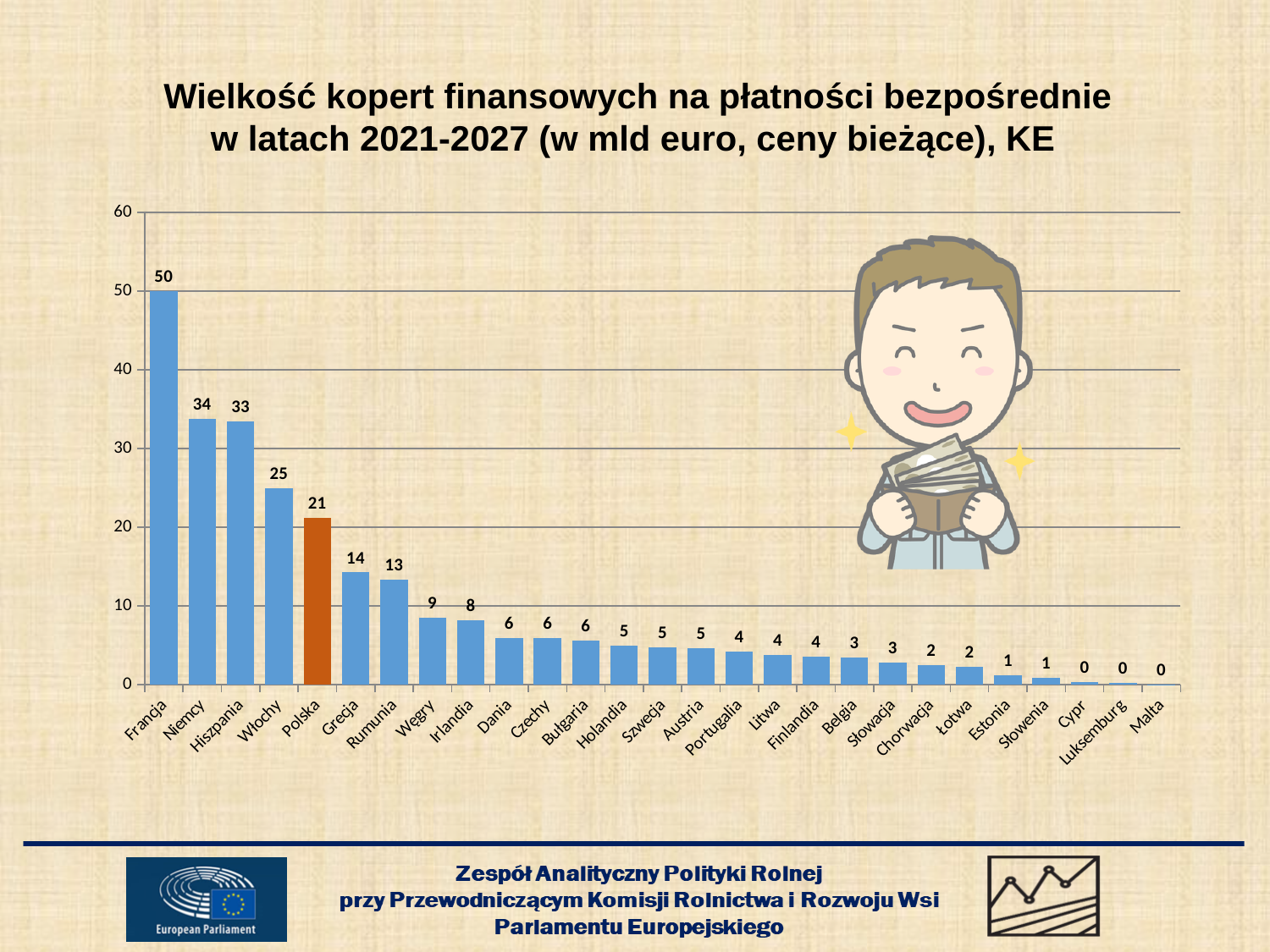
Is the value for Francja greater or less than 40? greater Which is larger, the value for Włochy or the value for Hiszpania? Hiszpania Which country has the highest value? Francja Which country's bar is coloured orange instead of blue? Polska What is the difference between the values for Polska and Grecja? 7 What is the value for Niemcy? 34 Do the values rise or fall from left to right along the x axis? fall What is the value for Polska? 21 What is the difference between the values for Francja and Niemcy? 16 What kind of chart is shown on the slide? bar chart What is the value for Rumunia? 13 How many countries are shown on the x axis? 27